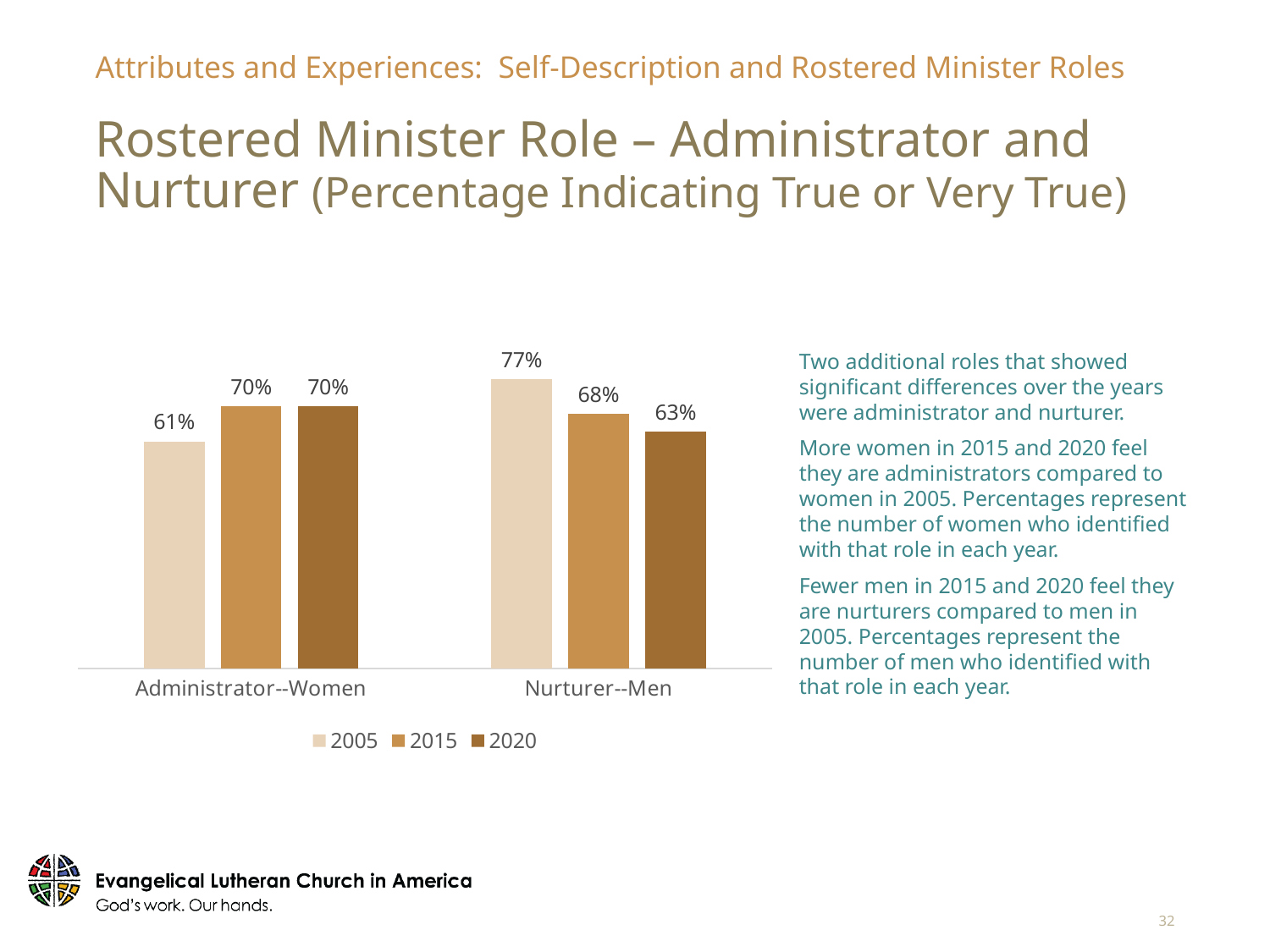
What percentage of women identified as administrators in 2005? 61% Which is larger: the 2005 value for Administrator--Women or the 2005 value for Nurturer--Men? Nurturer--Men How many series does the legend list? 3 Do the values for Nurturer--Men rise or fall from 2005 to 2020? Fall By how much did the Administrator--Women value increase from 2005 to 2015? 9% What is the difference between the 2005 and 2020 values for Nurturer--Men? 14% Which year has the highest value for Nurturer--Men? 2005 What percentage of men identified as nurturers in 2020? 63% Which year has the lowest value for Administrator--Women? 2005 What is the value for Nurturer--Men in 2015? 68% What kind of chart is shown on the slide? Bar chart How many categories are shown on the x axis? 2